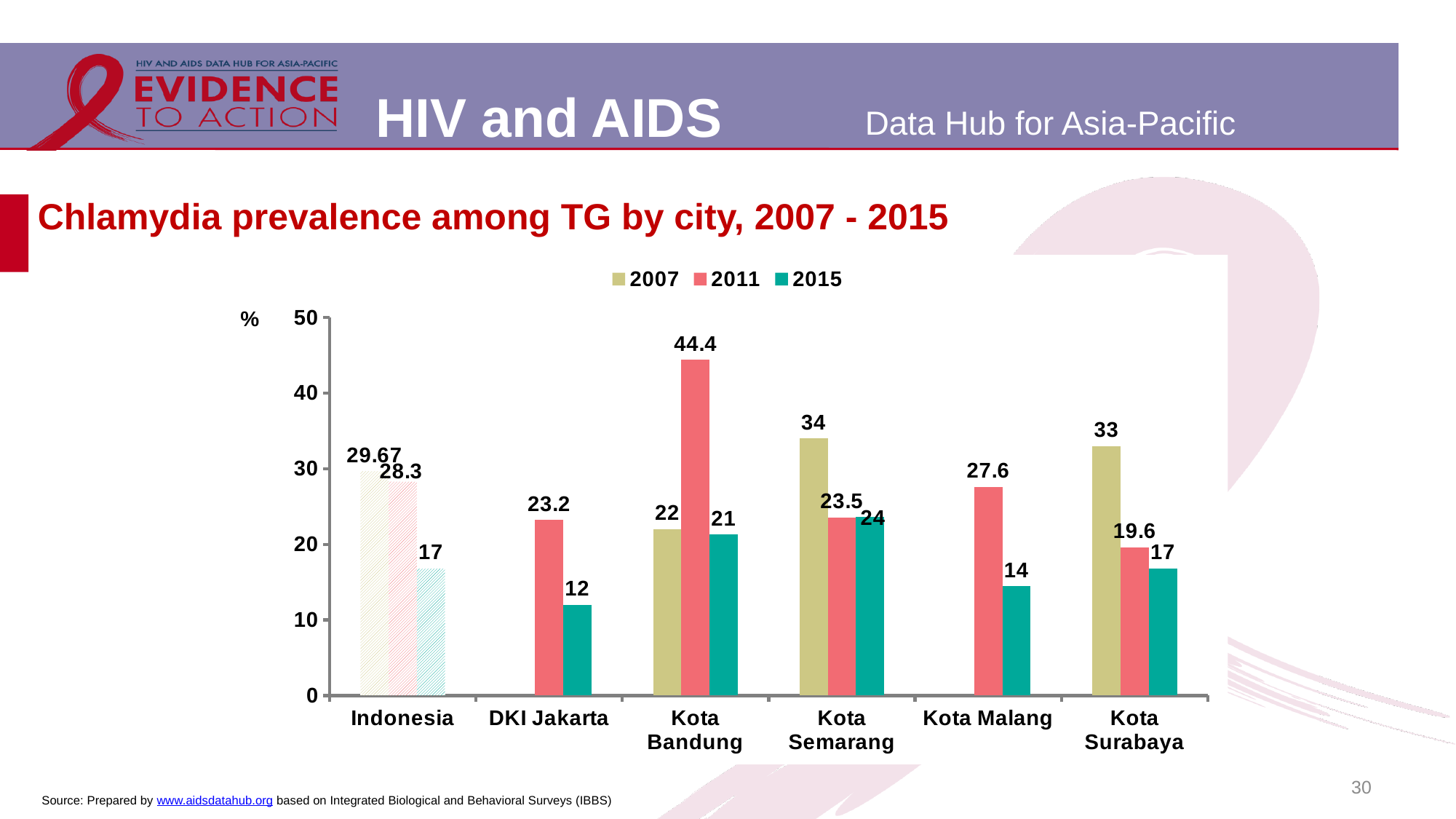
How many series does the legend list? 3 What is the difference between the 2011 and 2015 values for Kota Malang? 13.6 Which is larger: the 2007 value for Kota Semarang or the 2007 value for Kota Surabaya? Kota Semarang How many categories are shown on the x axis? 6 What kind of chart is shown on the slide? Bar chart What is the title of the chart? Chlamydia prevalence among TG by city, 2007 - 2015 Which category has the lowest 2015 value? DKI Jakarta What is the chlamydia prevalence among TG in Kota Bandung in 2011? 44.4 What is the 2015 value for DKI Jakarta? 12 What is the 2007 value for Kota Surabaya? 33 Do the values for Kota Surabaya rise or fall from 2007 to 2015? Fall Which city has the highest 2011 value? Kota Bandung